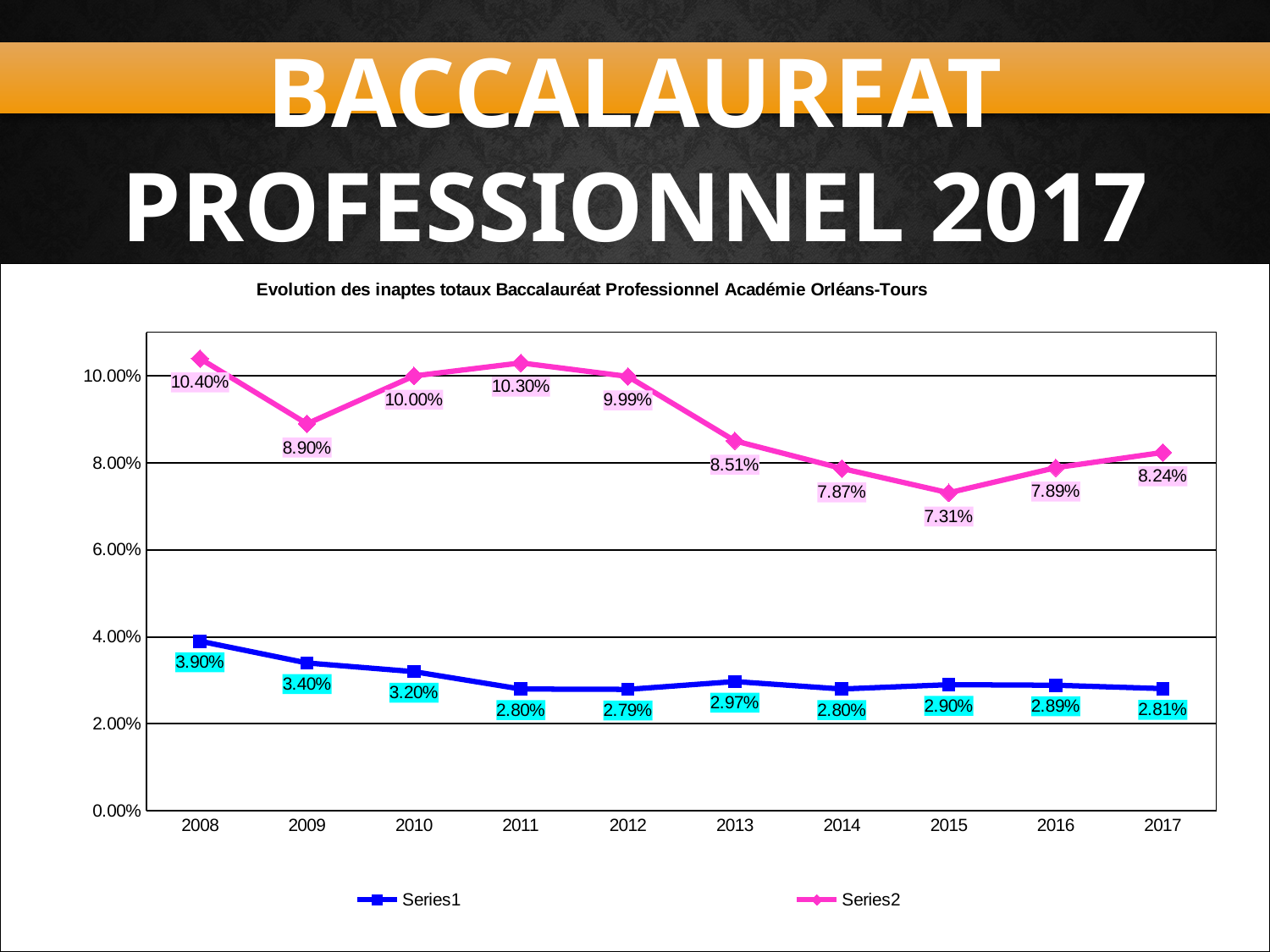
How many years are shown on the x axis? 10 Does Series1 generally rise or fall from 2008 to 2011? fall How many series does the legend list? 2 What kind of chart is shown on the slide? line chart What is the value of Series2 in 2008? 10.40% In which year is Series2 at its lowest? 2015 What is the value of Series2 in 2015? 7.31% What is the difference between the Series2 values for 2008 and 2017? 2.16% What is the title of the chart? Evolution des inaptes totaux Baccalauréat Professionnel Académie Orléans-Tours Which is larger, the Series1 value in 2013 or in 2014? 2013 In which year is Series1 at its highest? 2008 What is the value of Series1 in 2012? 2.79%